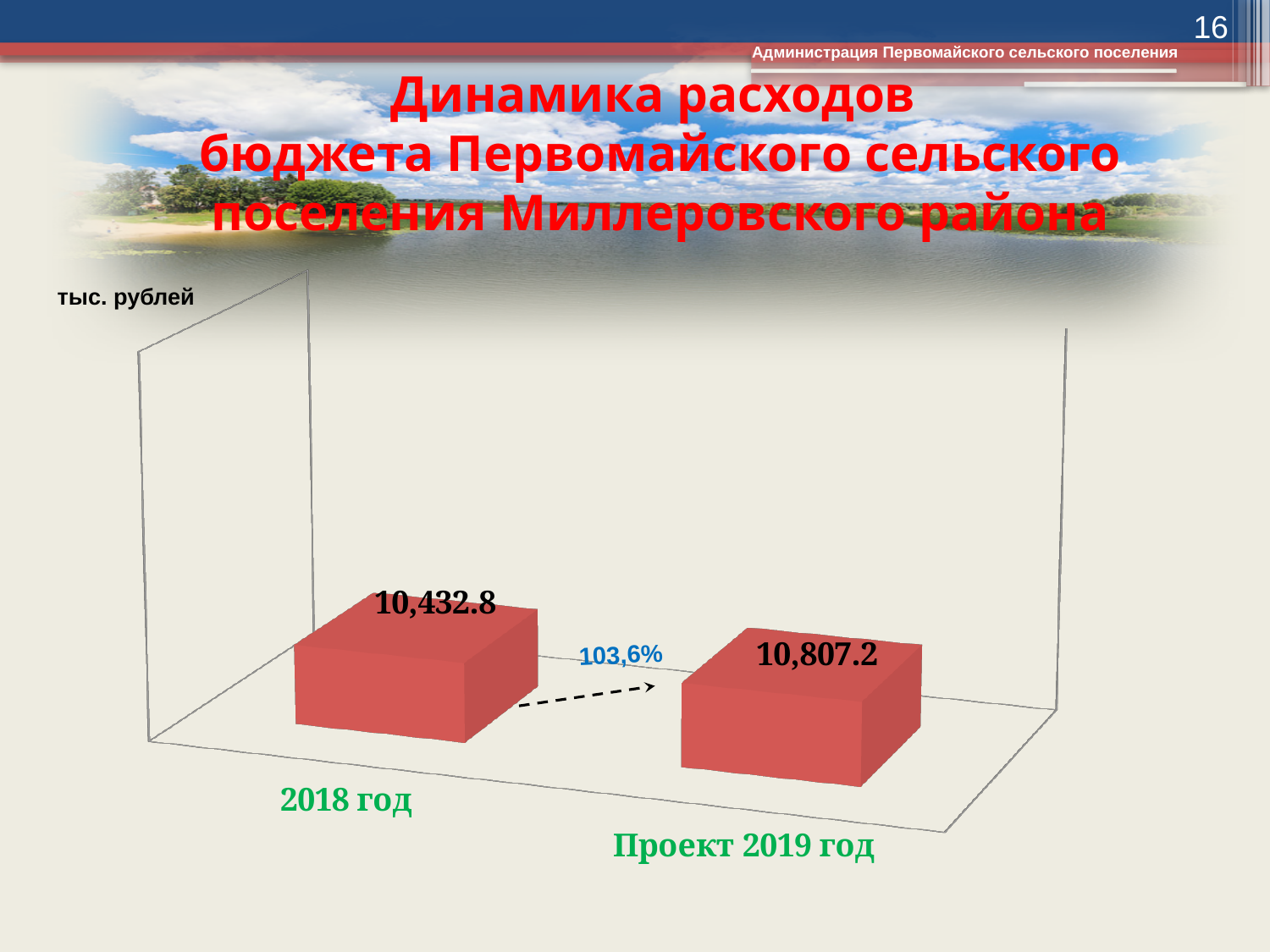
How many bars are plotted on the chart? 2 Do the values rise or fall from 2018 год to Проект 2019 год? rise Is the value for 2018 год larger or smaller than the value for Проект 2019 год? smaller What unit of measurement is indicated in the top-left corner of the chart? тыс. рублей What percentage is written on the arrow between the two bars? 103,6% What kind of chart is shown on the slide? bar chart What is the value shown for Проект 2019 год? 10,807.2 What is the difference between the value for Проект 2019 год and the value for 2018 год? 374.4 Which category has the lower value? 2018 год Which category has the higher value, 2018 год or Проект 2019 год? Проект 2019 год What is the value shown for 2018 год? 10,432.8